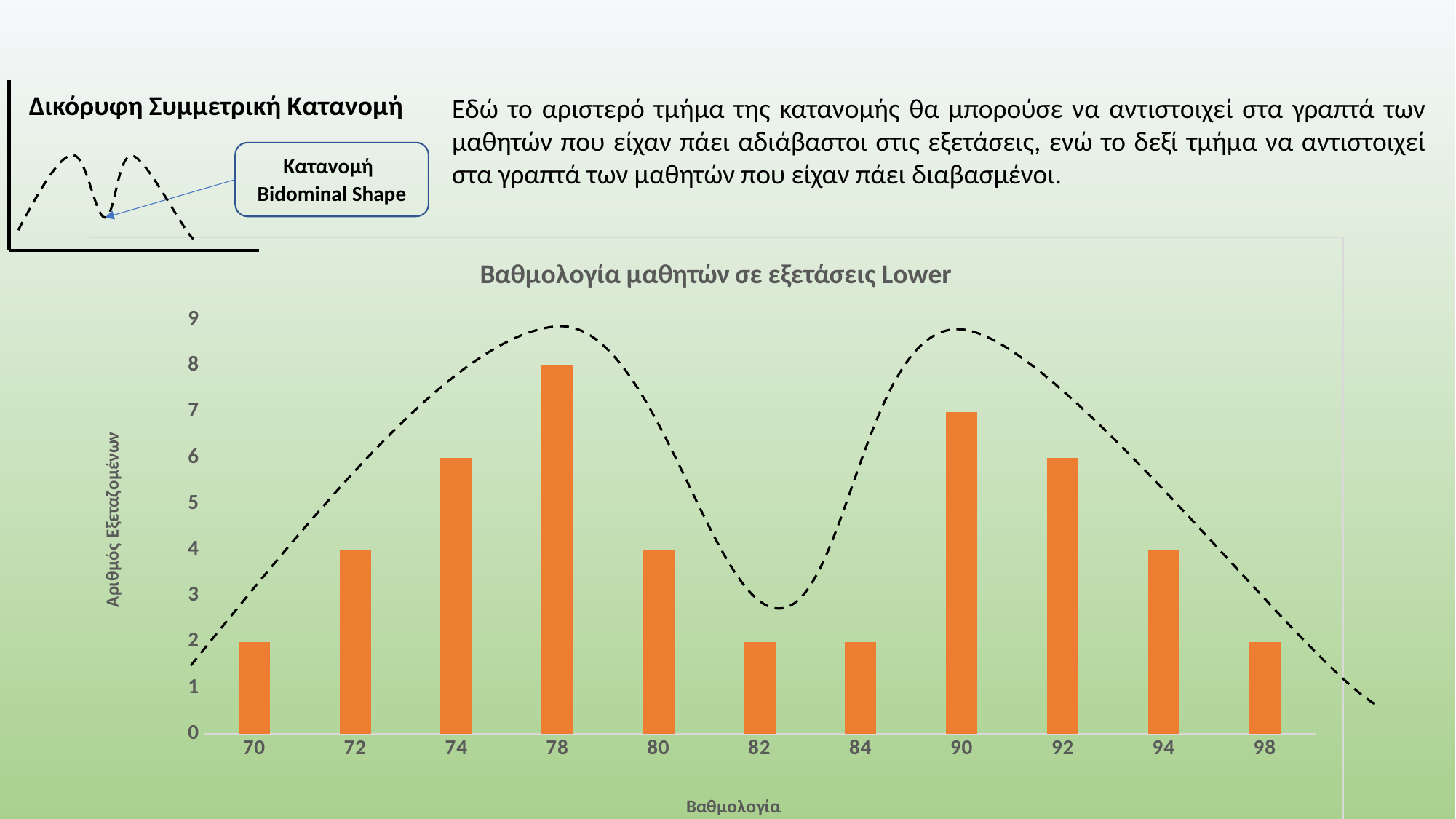
What is the number of examinees for the score 78? 8 What is the label of the vertical axis of the chart? Αριθμός Εξεταζομένων How many score categories are shown on the x axis of the chart? 11 Which score has the highest number of examinees in the chart? 78 Which has more examinees, score 72 or score 74? 74 What is the number of examinees for the score 74? 6 What is the number of examinees for the score 90? 7 What is the title of the chart? Βαθμολογία μαθητών σε εξετάσεις Lower Do the bar values rise or fall from score 70 to score 78? Rise Is the number of examinees for score 92 greater or less than 5? greater What kind of chart is shown on the slide? Bar chart What is the difference between the number of examinees for score 78 and score 90? 1